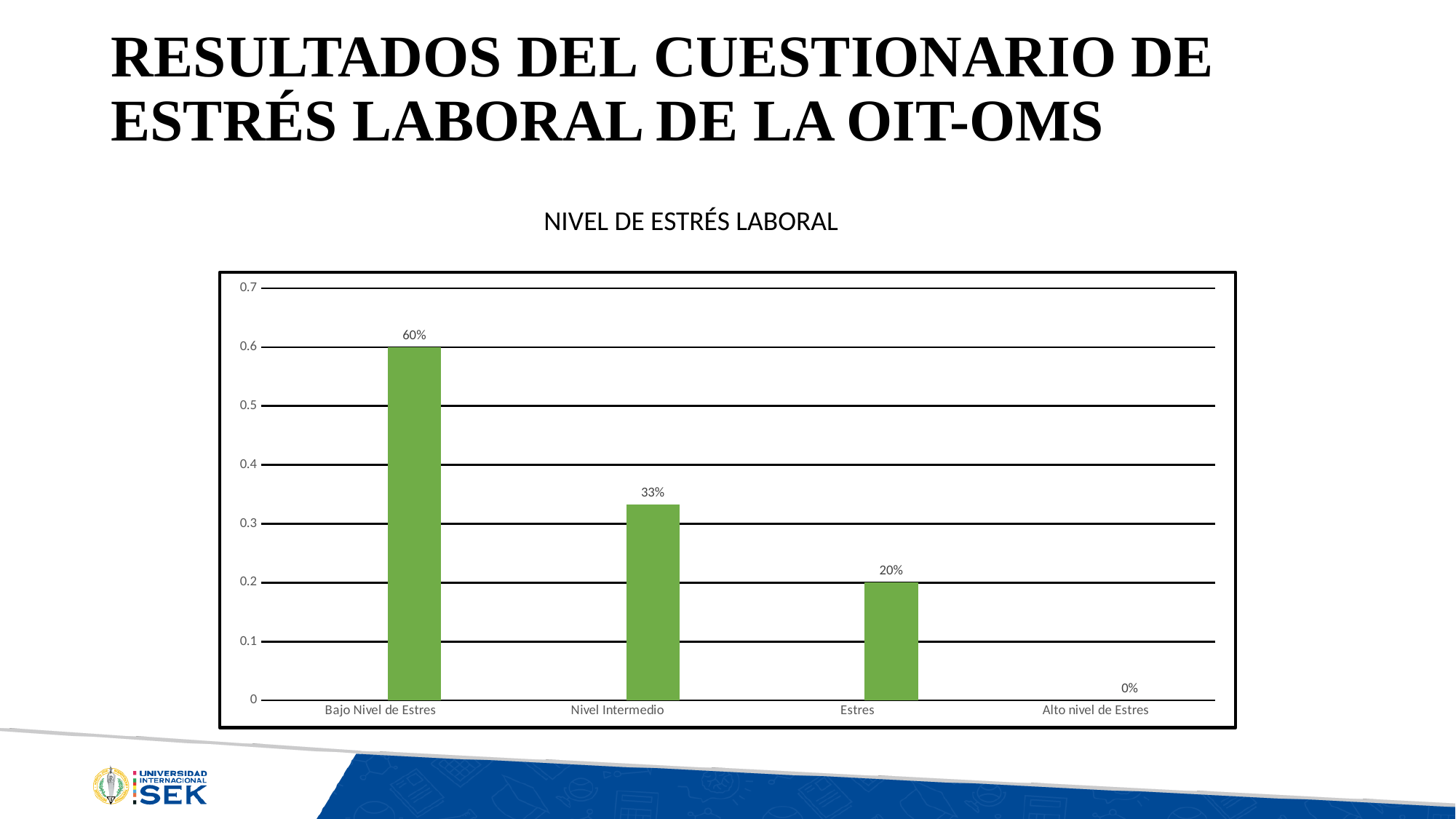
Which is larger, the value for Nivel Intermedio or the value for Estres? Nivel Intermedio Do the values rise or fall from left to right along the x axis? Fall What is the value for Bajo Nivel de Estres? 60% What is the value for Nivel Intermedio? 33% How many categories are shown on the x axis? 4 What is the title of the chart? NIVEL DE ESTRÉS LABORAL What is the value for Alto nivel de Estres? 0% Which category has the highest value? Bajo Nivel de Estres What is the difference between the values for Bajo Nivel de Estres and Nivel Intermedio? 27% Which category has the lowest value? Alto nivel de Estres What is the value for Estres? 20% What kind of chart is shown on the slide? Bar chart